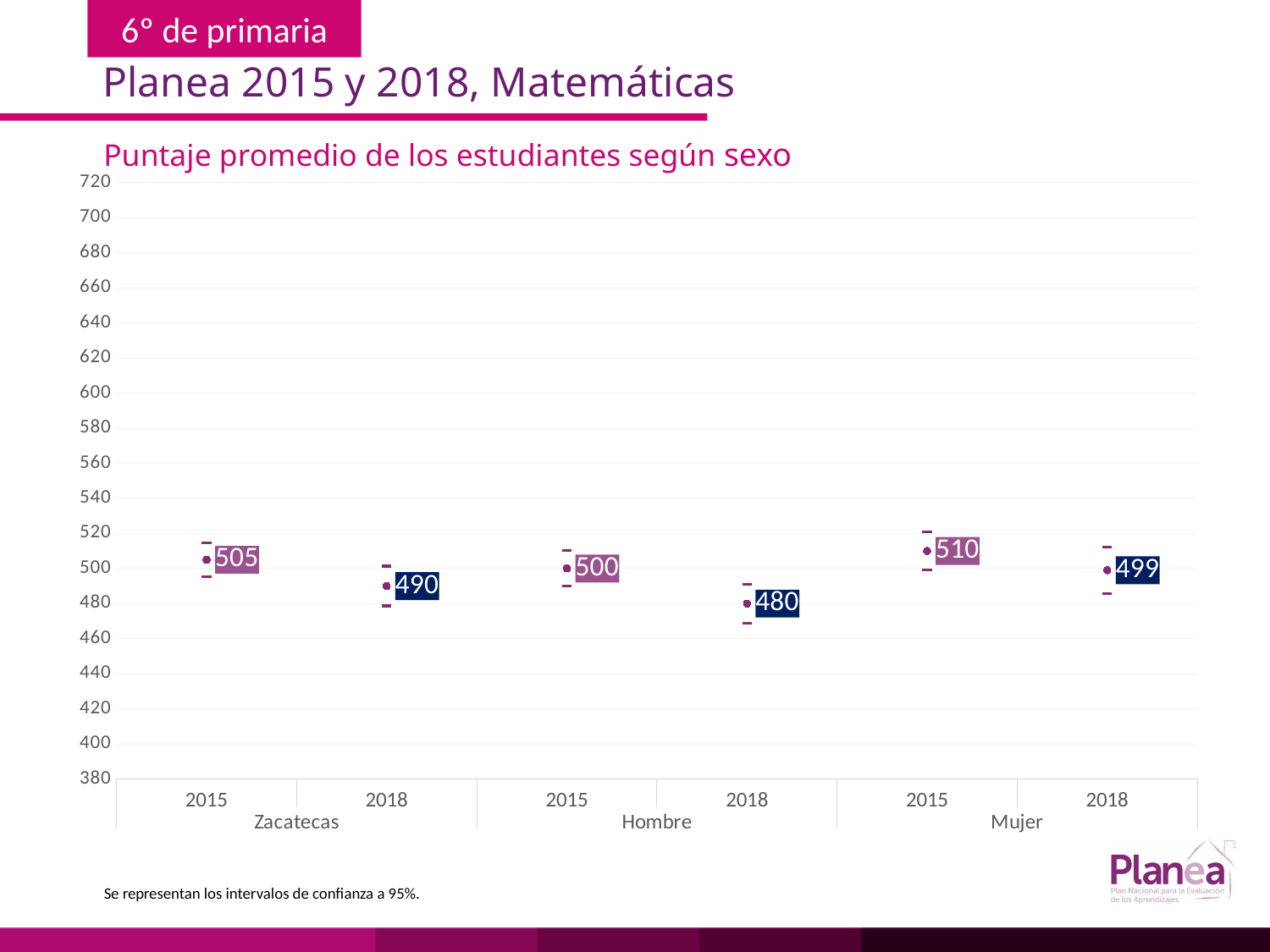
Did the Hombre average score rise or fall from 2015 to 2018? fall What is the title of the chart? Puntaje promedio de los estudiantes según sexo What is the average score for Mujer in 2018? 499 How many data points are plotted on the chart? 6 What is the difference between the Zacatecas scores in 2015 and 2018? 15 What is the difference between the Hombre scores in 2015 and 2018? 20 Which is larger, the Mujer 2018 score or the Hombre 2018 score? Mujer 2018 What is the average score for Zacatecas in 2015? 505 What is the average score for Hombre in 2018? 480 Which group and year has the highest average score? Mujer 2015 What is the average score for Mujer in 2015? 510 Which group and year has the lowest average score? Hombre 2018